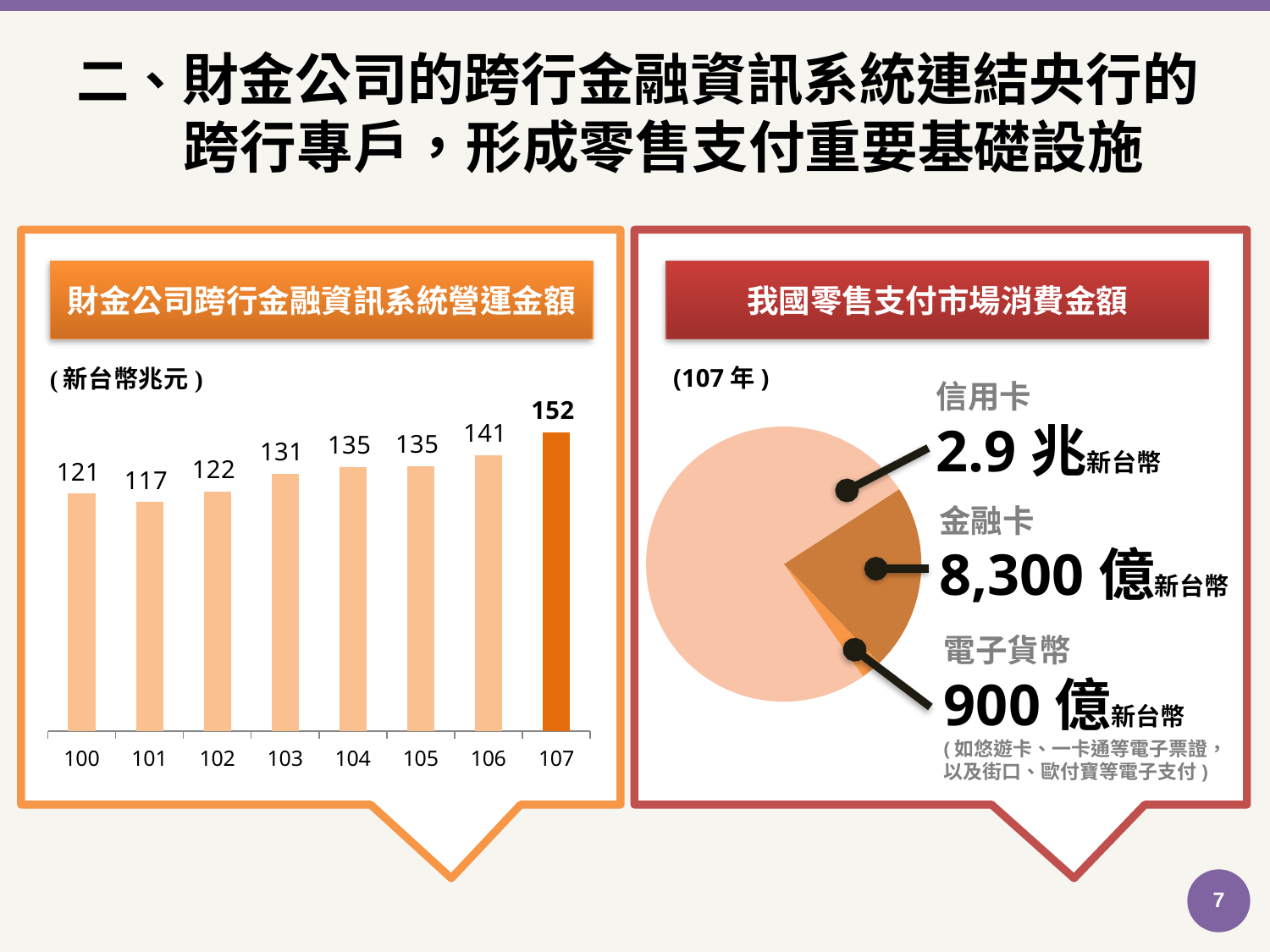
In the bar chart titled 財金公司跨行金融資訊系統營運金額, which is larger, the value for year 102 or the value for year 101? 102 In the bar chart titled 財金公司跨行金融資訊系統營運金額, what unit is stated for the values? 新台幣兆元 In the pie chart titled 我國零售支付市場消費金額, what is the value for 金融卡? 8,300 億新台幣 In the bar chart titled 財金公司跨行金融資訊系統營運金額, do the values generally rise or fall from year 101 to year 107? rise In the bar chart titled 財金公司跨行金融資訊系統營運金額, what is the value for year 103? 131 In the pie chart titled 我國零售支付市場消費金額, which category has the largest slice? 信用卡 In the bar chart titled 財金公司跨行金融資訊系統營運金額, what is the value for year 107? 152 In the bar chart titled 財金公司跨行金融資訊系統營運金額, what is the difference between the values for year 107 and year 100? 31 In the bar chart titled 財金公司跨行金融資訊系統營運金額, which year has the highest value? 107 In the bar chart titled 財金公司跨行金融資訊系統營運金額, how many years are shown on the x axis? 8 What kind of chart is the one titled 財金公司跨行金融資訊系統營運金額? bar chart In the bar chart titled 財金公司跨行金融資訊系統營運金額, which year has the lowest value? 101